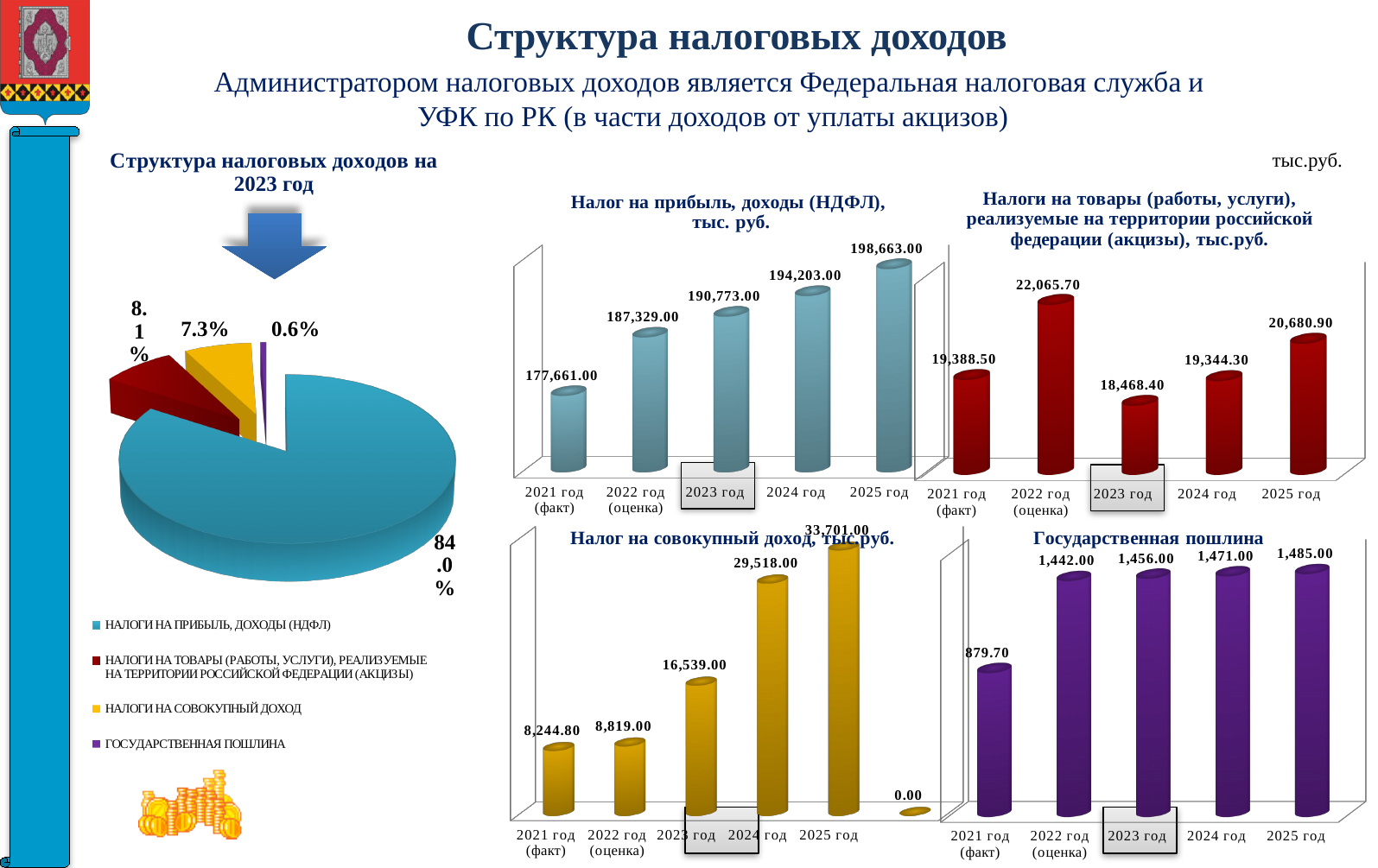
In the chart 'Налоги на товары (работы, услуги), реализуемые на территории российской федерации (акцизы), тыс.руб.', which year has the lowest value? 2023 год In the chart 'Налог на совокупный доход, тыс.руб.', what is the value for 2024 год? 29,518.00 What kind of chart is 'Структура налоговых доходов на 2023 год'? pie chart In the chart 'Налоги на товары (работы, услуги), реализуемые на территории российской федерации (акцизы), тыс.руб.', which year has the highest value? 2022 год (оценка) In the chart 'Государственная пошлина', what is the value for 2021 год (факт)? 879.70 In the chart 'Государственная пошлина', which is larger: the value for 2022 год (оценка) or 2023 год? 2023 год In the chart 'Налог на прибыль, доходы (НДФЛ), тыс. руб.', what is the value for 2023 год? 190,773.00 In the chart 'Налоги на товары (работы, услуги), реализуемые на территории российской федерации (акцизы), тыс.руб.', what is the value for 2025 год? 20,680.90 In the chart 'Налог на совокупный доход, тыс.руб.', what is the difference between the values for 2025 год and 2024 год? 4,183.00 In the pie chart 'Структура налоговых доходов на 2023 год', what share does 'ГОСУДАРСТВЕННАЯ ПОШЛИНА' have? 0.6% In the pie chart 'Структура налоговых доходов на 2023 год', what share does 'НАЛОГИ НА ПРИБЫЛЬ, ДОХОДЫ (НДФЛ)' have? 84.0% In the chart 'Налог на прибыль, доходы (НДФЛ), тыс. руб.', do the values rise or fall from 2021 год to 2025 год? rise